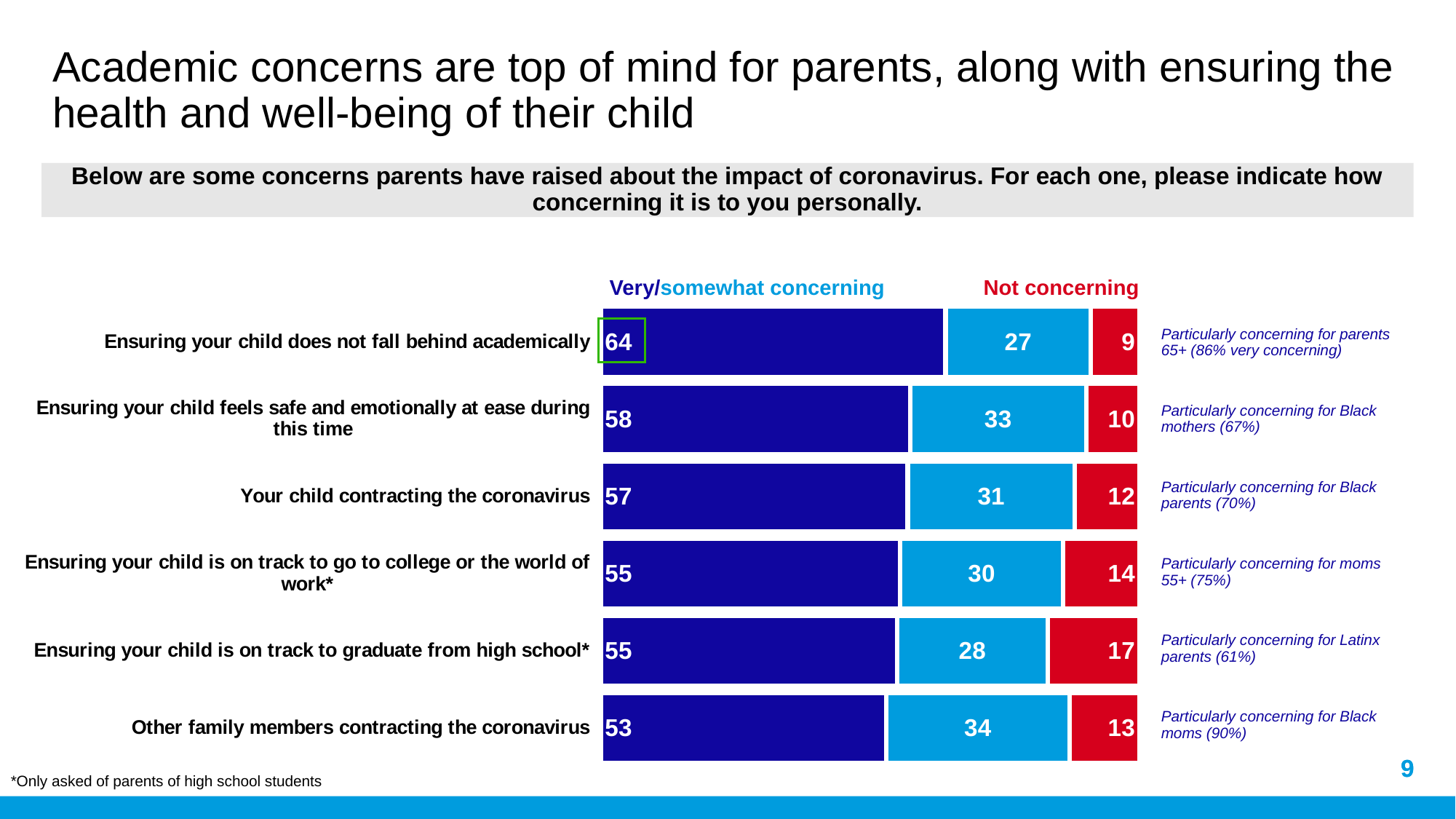
What is the total of the stacked bar for 'Your child contracting the coronavirus'? 100 How many categories (concerns) are shown in the chart? 6 What kind of chart is shown on the slide? Stacked bar chart Which category has the lowest 'Very concerning' value? Other family members contracting the coronavirus What is the 'Somewhat concerning' value for 'Other family members contracting the coronavirus'? 34 Which category has the highest 'Not concerning' value? Ensuring your child is on track to graduate from high school* What is the 'Very concerning' value for 'Ensuring your child does not fall behind academically'? 64 What is the difference between the 'Very concerning' values for 'Ensuring your child does not fall behind academically' and 'Your child contracting the coronavirus'? 7 Which category has the highest 'Very concerning' value? Ensuring your child does not fall behind academically What is the 'Not concerning' value for 'Ensuring your child is on track to graduate from high school*'? 17 Which is larger: the 'Somewhat concerning' value for 'Ensuring your child feels safe and emotionally at ease during this time' or for 'Ensuring your child does not fall behind academically'? Ensuring your child feels safe and emotionally at ease during this time How many series does the chart show? 3